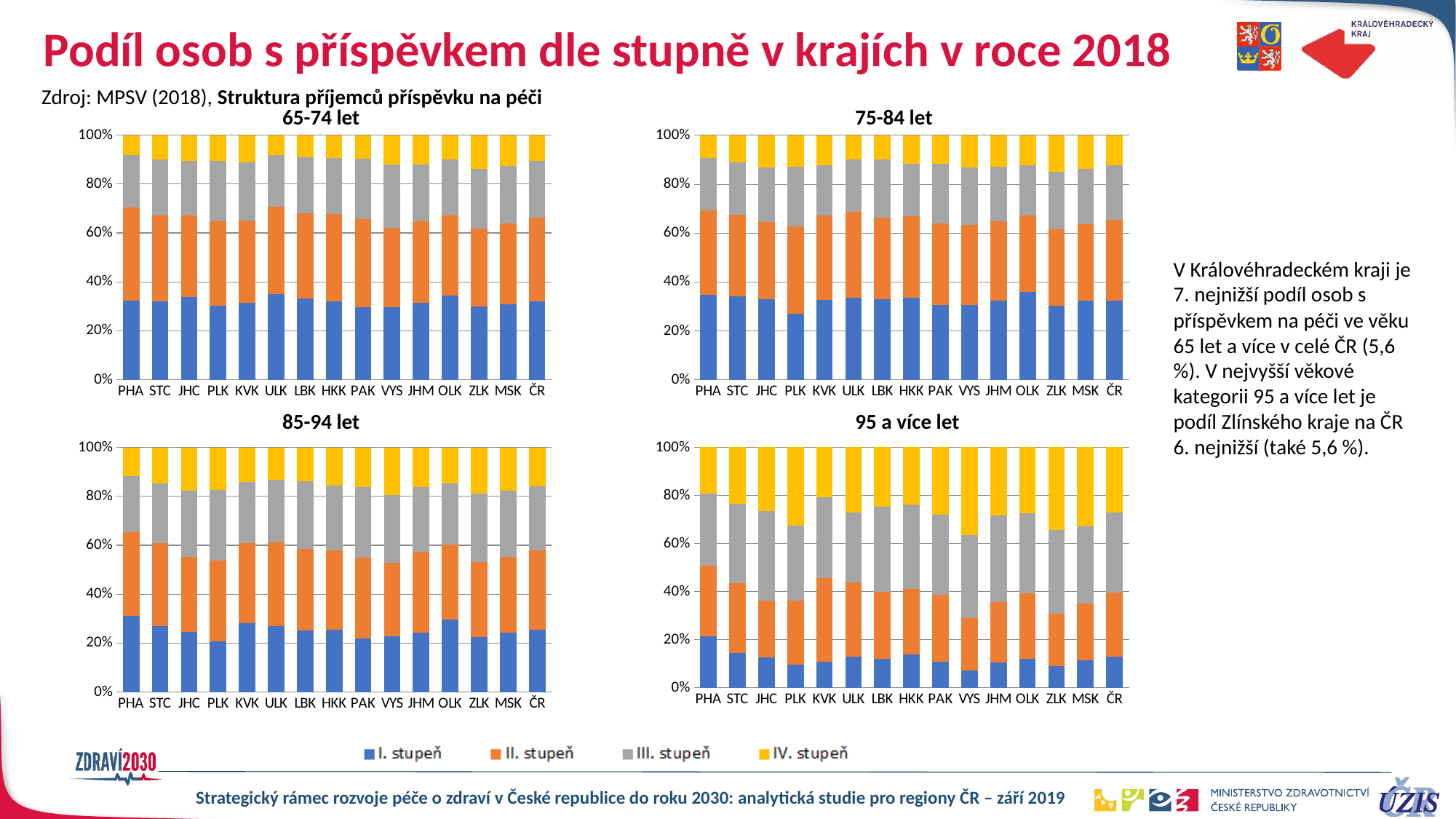
In the '95 a více let' chart, which region has the largest I. stupeň share? PHA Which series are listed in the legend? I. stupeň, II. stupeň, III. stupeň, IV. stupeň What kind of chart is the '65-74 let' chart? stacked bar chart In the '95 a více let' chart, which has the larger I. stupeň share, PHA or VYS? PHA In the '75-84 let' chart, is the I. stupeň share for PLK greater or less than 40%? less In the '85-94 let' chart, what do the four stacked segments of each bar add up to? 100% In the '85-94 let' chart, is the I. stupeň share for PHA greater or less than 20%? greater What is the title of the bottom-right chart? 95 a více let How many series does the shared legend list? 4 In the '95 a více let' chart, is the I. stupeň share for VYS greater or less than 20%? less How many regions (categories) are shown on the x axis of the '75-84 let' chart? 15